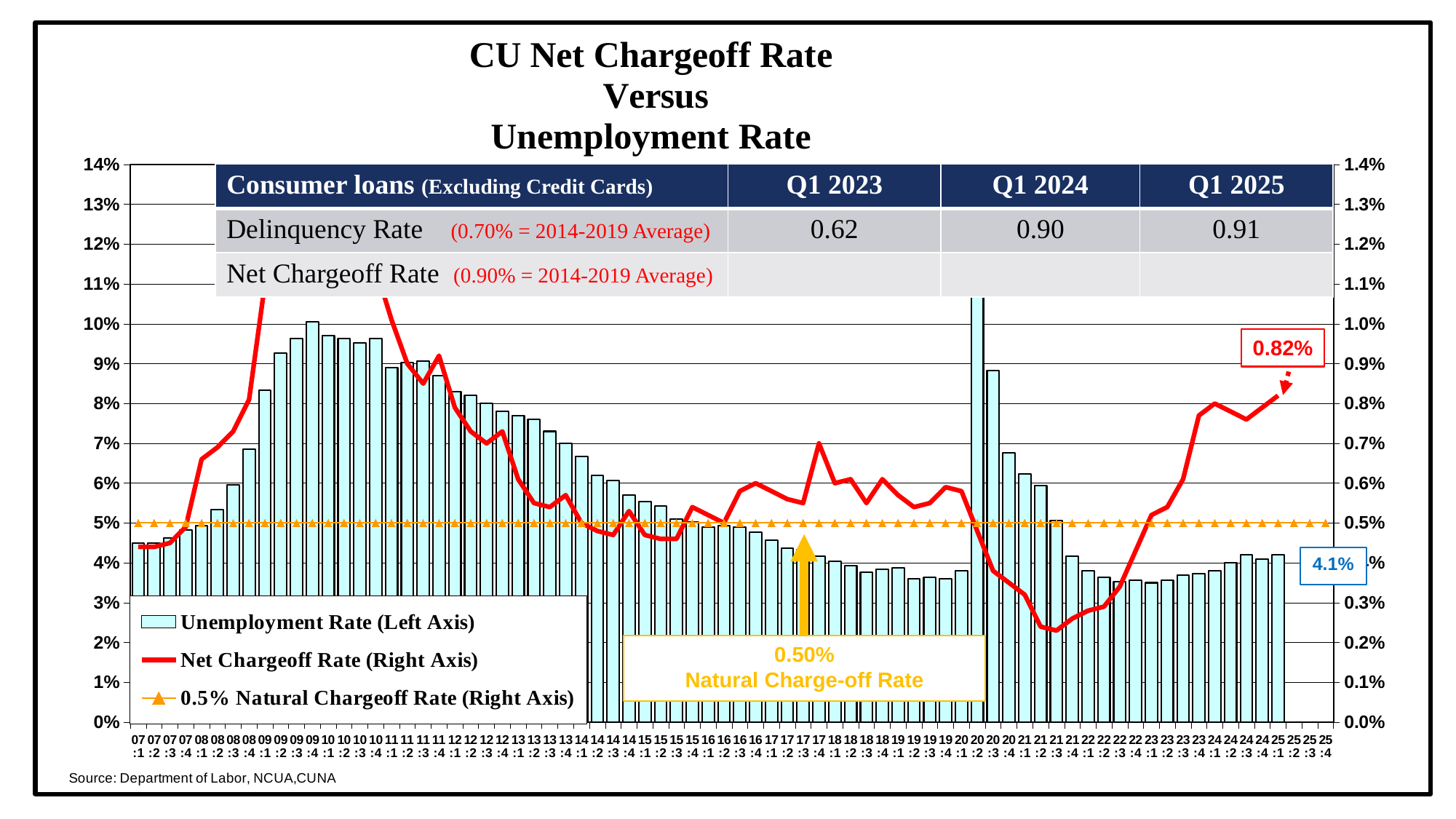
Does the Net Chargeoff Rate line rise or fall from 22:3 to 25:1? rise Which quarter has the highest Unemployment Rate bar? 20:2 What value is given for the Natural Charge-off Rate? 0.50% What is the difference between the Delinquency Rate in Q1 2025 and Q1 2023 in the table? 0.29 Is the Net Chargeoff Rate at 21:3 greater or less than 0.3%? less How many series does the chart legend list? 3 What is the most recent Net Chargeoff Rate value labeled on the chart? 0.82% Which is higher, the Unemployment Rate bar for 20:2 or for 21:1? 20:2 Is the Unemployment Rate bar for 20:2 greater or less than 10%? greater According to the table, what was the Delinquency Rate for consumer loans in Q1 2024? 0.90 What kind of chart is shown on the slide? A combination bar and line chart What is the most recent Unemployment Rate value labeled on the chart? 4.1%